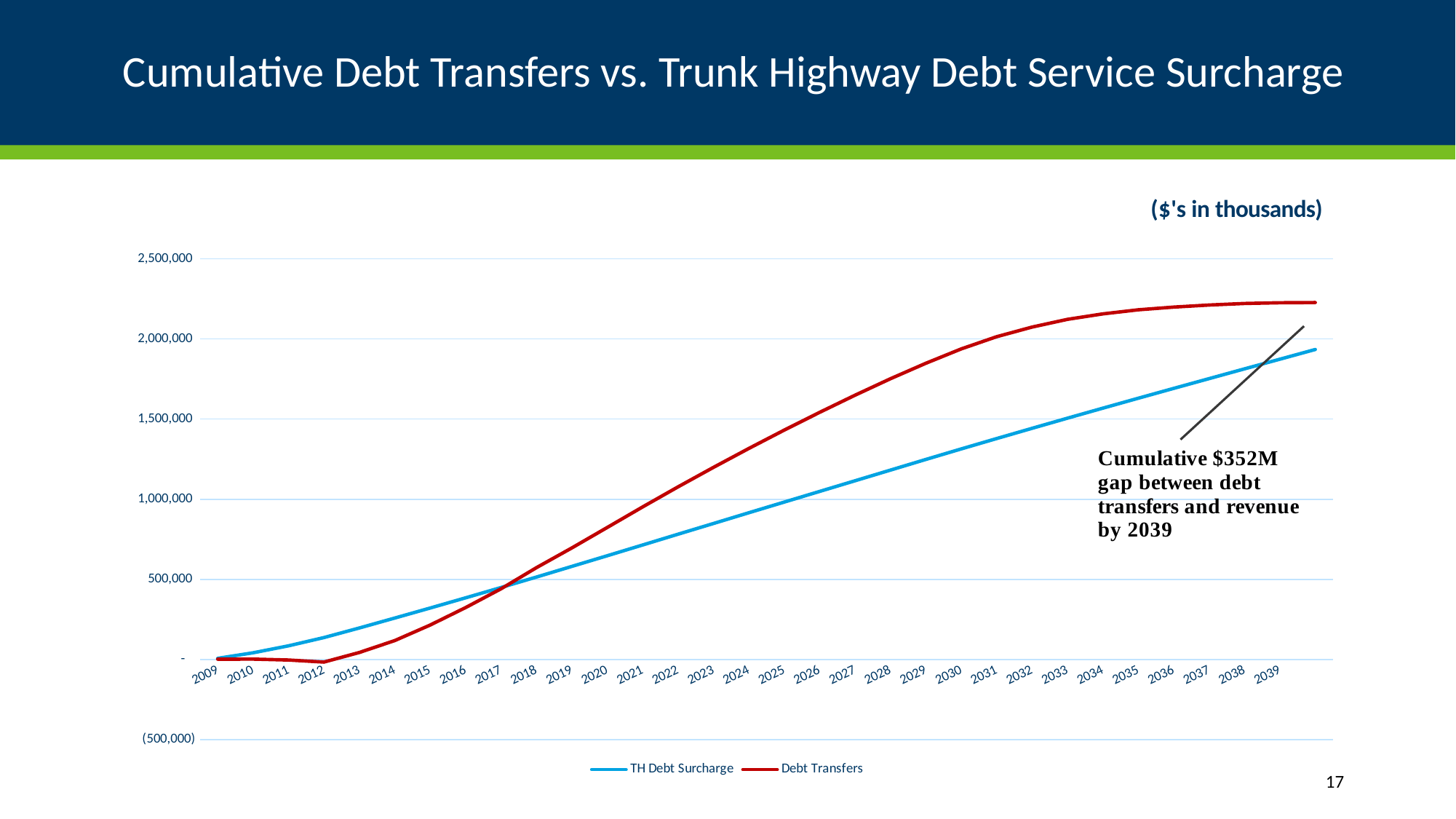
Is the value for Debt Transfers in 2039 greater or less than 2,000,000? greater Does the Debt Transfers series rise or fall from 2013 to 2039? Rise What kind of chart is shown on the slide? Line chart How many series does the legend list? 2 Is the value for Debt Transfers in 2012 greater or less than 500,000? less Which series is drawn in red? Debt Transfers Is the value for Debt Transfers in 2025 greater or less than 1,000,000? greater In 2014, which series has the larger value, TH Debt Surcharge or Debt Transfers? TH Debt Surcharge In 2039, which series has the larger value, TH Debt Surcharge or Debt Transfers? Debt Transfers According to the annotation, what is the cumulative gap between debt transfers and revenue by 2039? $352M How many years are plotted along the x axis? 31